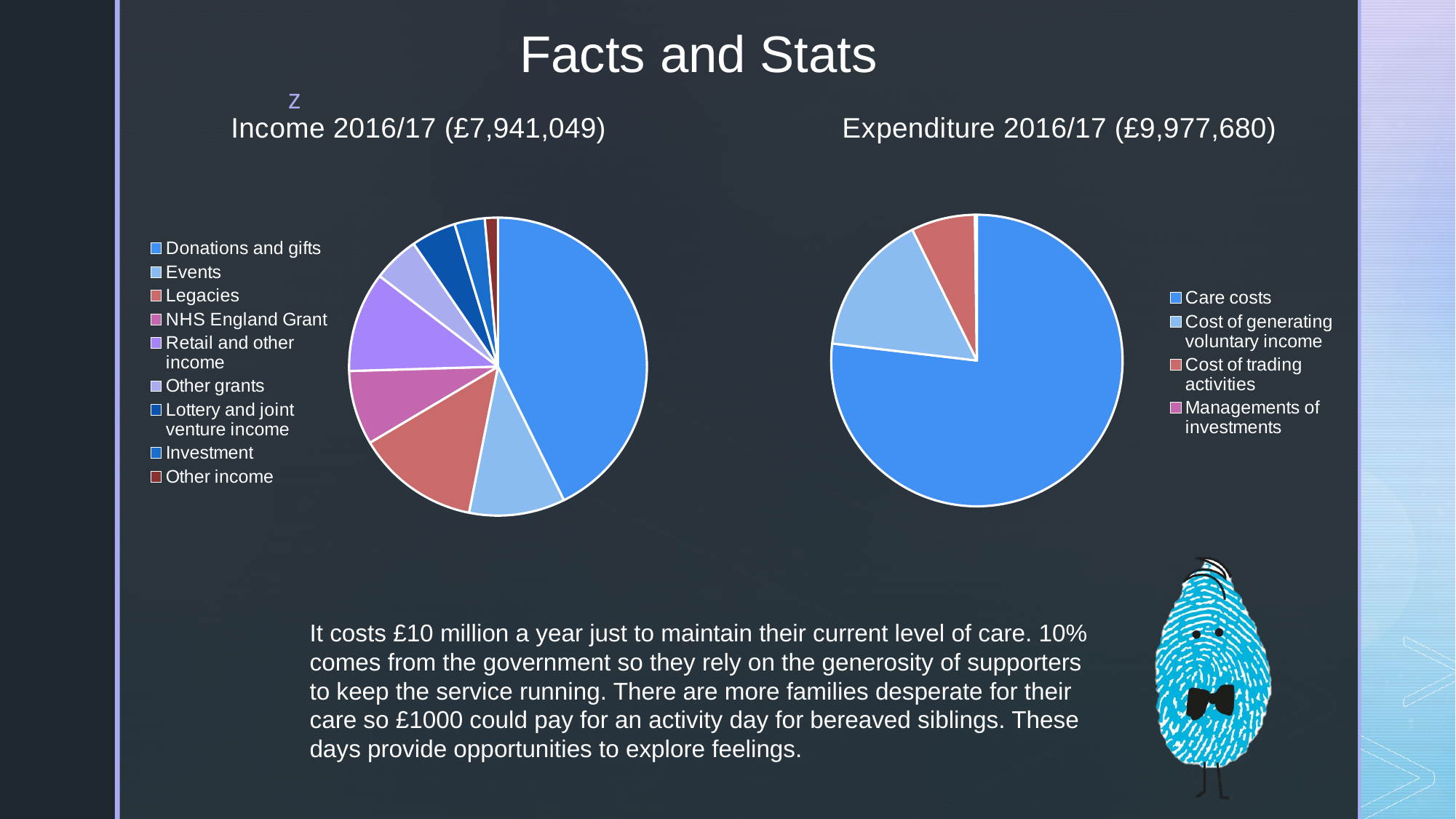
In the Income 2016/17 chart, which is larger: Donations and gifts or Events? Donations and gifts What kind of chart is the Income 2016/17 chart? Pie chart In the Expenditure 2016/17 chart, which is larger: Cost of generating voluntary income or Cost of trading activities? Cost of generating voluntary income How many categories does the legend of the Income 2016/17 chart list? 9 What total expenditure figure is shown in the title of the Expenditure 2016/17 chart? £9,977,680 What total income figure is shown in the title of the Income 2016/17 chart? £7,941,049 In the Income 2016/17 chart, which category has the smallest visible slice? Other income In the Income 2016/17 chart, which is larger: Legacies or Other grants? Legacies In the Expenditure 2016/17 chart, which category has the largest slice? Care costs How many categories does the legend of the Expenditure 2016/17 chart list? 4 In the Income 2016/17 chart, which category has the largest slice? Donations and gifts